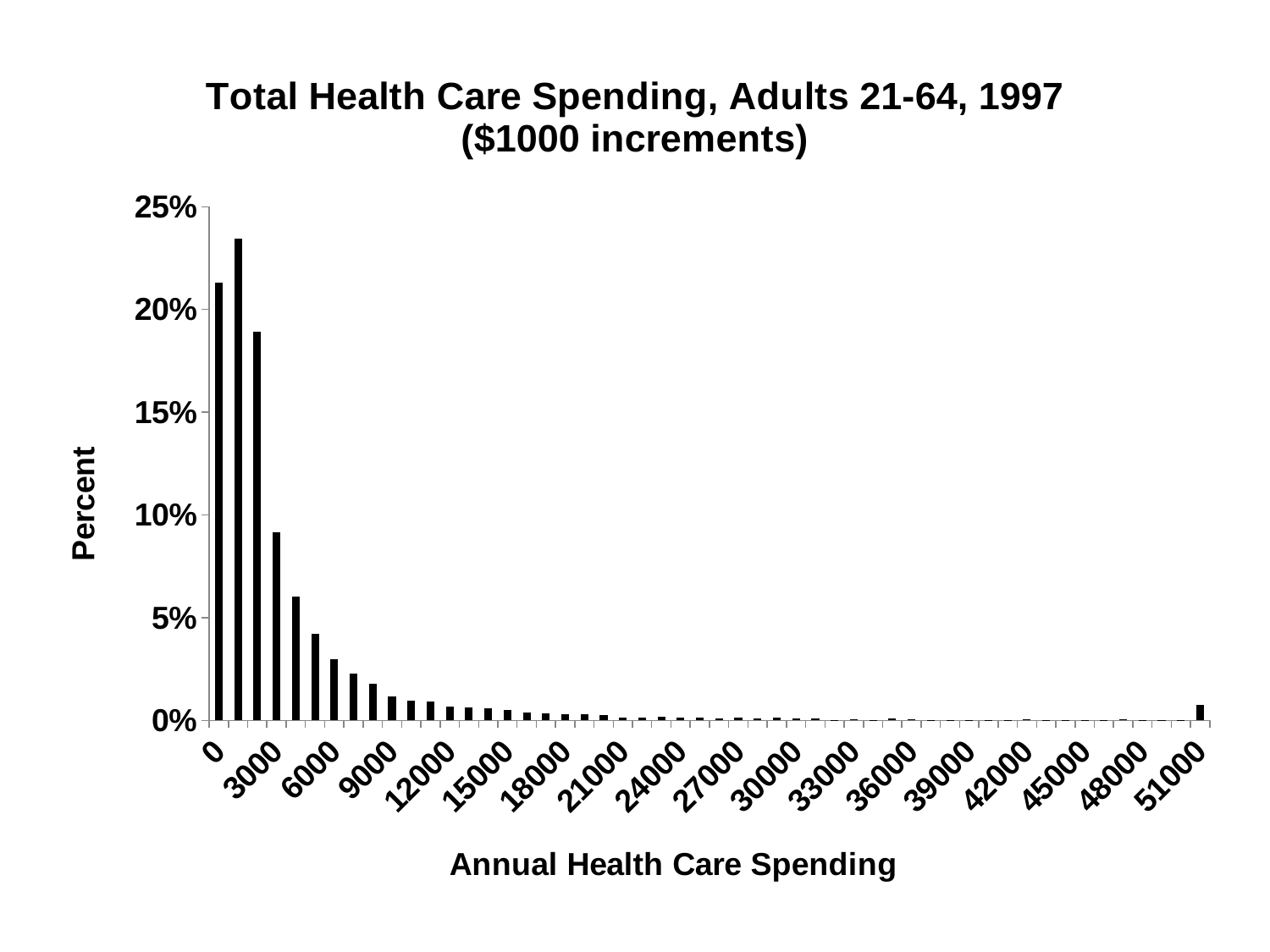
Is the value for the 3000 spending category greater or less than 10%? less Is the value for the 1000 spending category greater or less than 20%? greater Is the value for the 4000 spending category greater or less than 5%? greater Which has the larger value, the 0 category or the 2000 category? 0 Beyond the 1000 category, do the values generally rise or fall as annual health care spending increases? fall What kind of chart is shown on the slide? bar chart What is the title of the chart? Total Health Care Spending, Adults 21-64, 1997 ($1000 increments) Which spending category has the highest bar? 1000 What is the label on the vertical axis of the chart? Percent